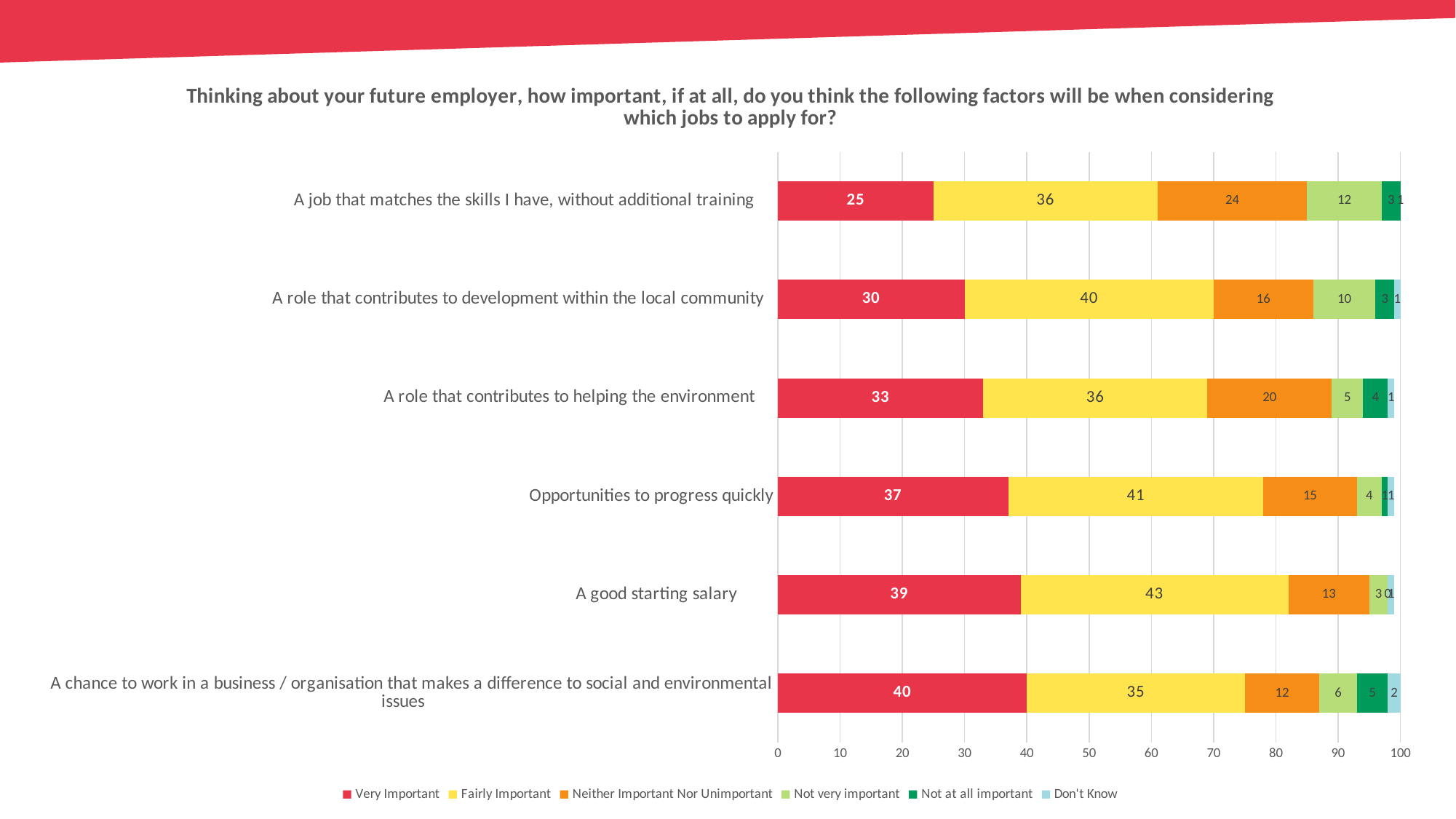
Which is larger: the Fairly Important value for 'A good starting salary' or for 'A role that contributes to development within the local community'? A good starting salary How many categories (factors) are plotted on the chart? 6 What is the Neither Important Nor Unimportant value for 'A job that matches the skills I have, without additional training'? 24 How many series does the legend list? 6 What is the Not very important value for 'A role that contributes to development within the local community'? 10 What is the Very Important value for 'A good starting salary'? 39 Which series is shown in red in the legend? Very Important Which category has the lowest Very Important value? A job that matches the skills I have, without additional training What type of chart is shown on the slide? Stacked bar chart Which category has the highest Very Important value? A chance to work in a business / organisation that makes a difference to social and environmental issues What is the difference between the Very Important values for 'A good starting salary' and 'A role that contributes to helping the environment'? 6 What is the Fairly Important value for 'Opportunities to progress quickly'? 41